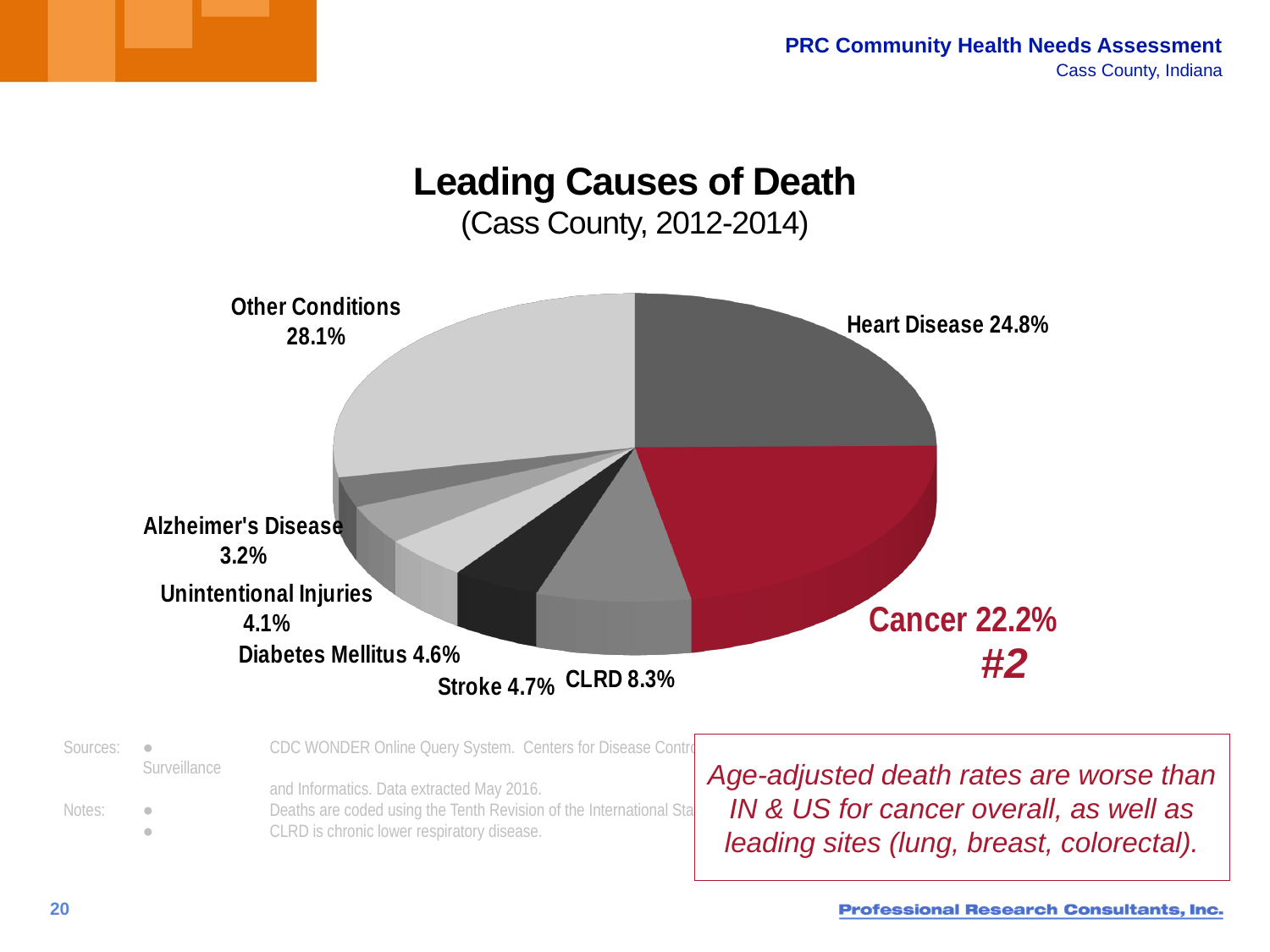
What percentage of the pie is Cancer? 22.2% What is the difference in percentage points between Heart Disease and Cancer? 2.6 What is the combined share of Heart Disease and Cancer? 47.0% What share of deaths is attributed to Heart Disease? 24.8% What kind of chart is shown on the slide? pie chart What is the title of the chart? Leading Causes of Death (Cass County, 2012-2014) What is the value shown for CLRD? 8.3% Which cause of death has the smallest slice? Alzheimer's Disease How many slices does the pie chart have? 8 Which is larger, the slice for Stroke or the slice for Unintentional Injuries? Stroke What percentage is shown for Alzheimer's Disease? 3.2% Which slice of the pie is the largest? Other Conditions